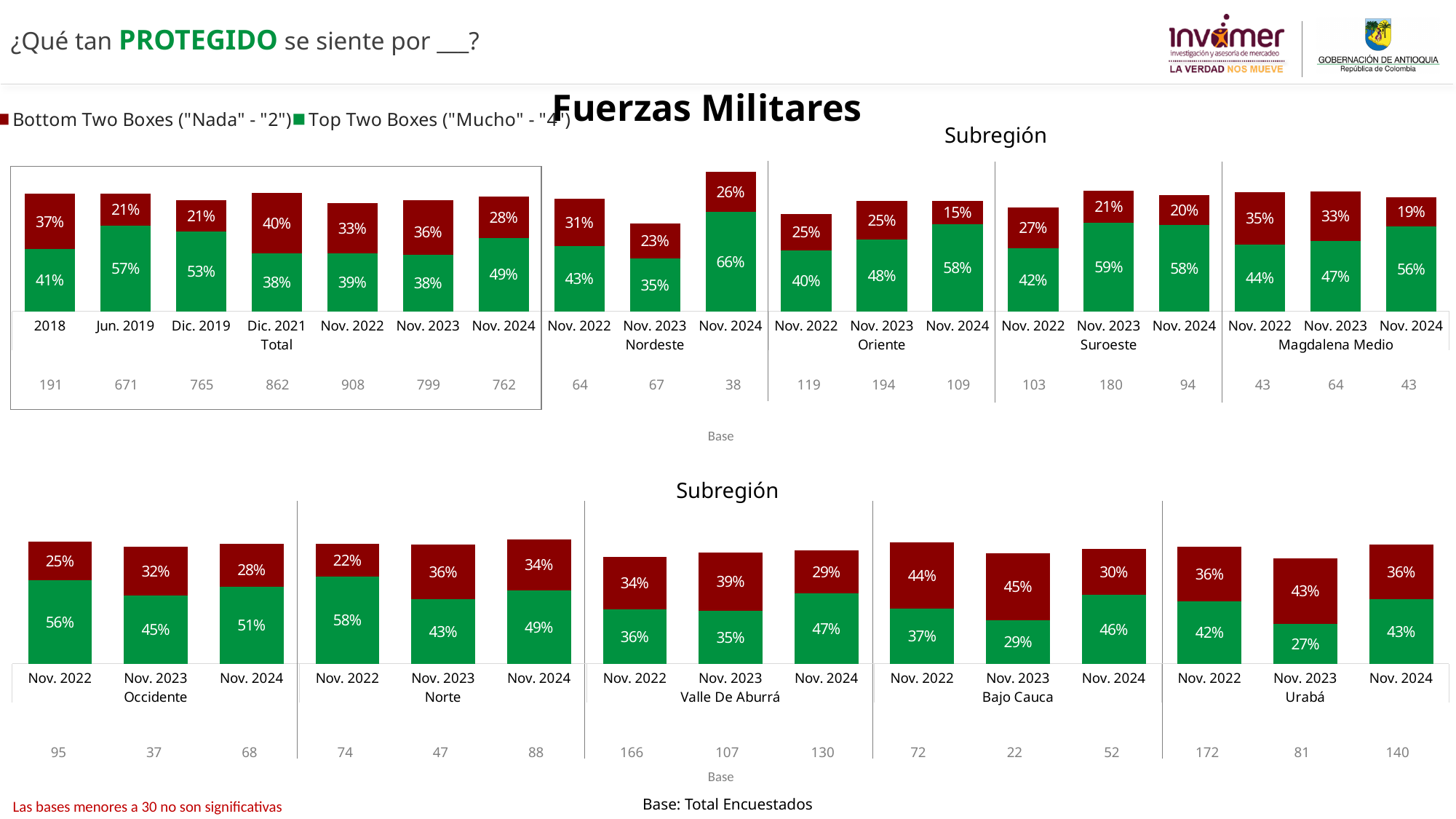
In the top chart, what is the combined total of the Bottom Two Boxes and Top Two Boxes segments for Oriente in Nov. 2024? 73% In the bottom chart, which bar has the lowest Top Two Boxes value? Nov. 2023 Urabá (27%) How many series does the legend list? 2 What is the base (number of respondents) shown for Total in Nov. 2024 in the top chart? 762 In the bottom chart, which has the larger Top Two Boxes value in Nov. 2022: Norte or Occidente? Norte How many subregions are shown in the bottom chart? 5 What kind of chart is used on this slide? Stacked bar chart In the top chart, does the Top Two Boxes value for Oriente rise or fall from Nov. 2022 to Nov. 2024? Rise In the top chart, what is the Top Two Boxes value for Nordeste in Nov. 2024? 66% In the top chart, how much higher is the Top Two Boxes value for Total in Jun. 2019 than in 2018? 16 percentage points In the top chart, which bar has the highest Top Two Boxes value? Nov. 2024 Nordeste (66%) In the bottom chart, what is the Bottom Two Boxes value for Bajo Cauca in Nov. 2023? 45%